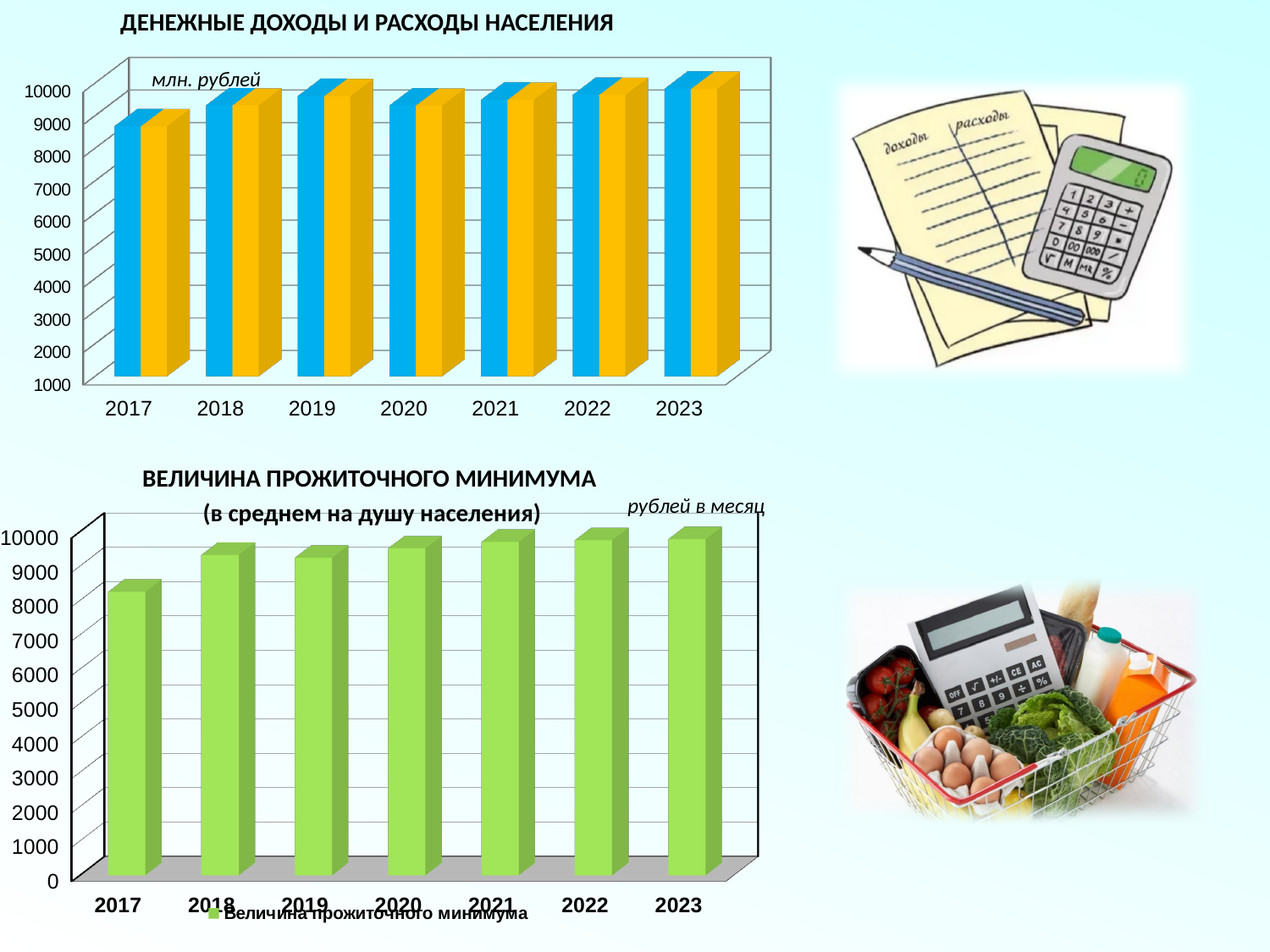
In the bottom chart 'ВЕЛИЧИНА ПРОЖИТОЧНОГО МИНИМУМА', is the value for 2017 greater or less than 9000? less In the top chart 'ДЕНЕЖНЫЕ ДОХОДЫ И РАСХОДЫ НАСЕЛЕНИЯ', is the blue bar for 2019 greater or less than 9000? greater In the bottom chart 'ВЕЛИЧИНА ПРОЖИТОЧНОГО МИНИМУМА', how many series does the legend list? 1 In the bottom chart 'ВЕЛИЧИНА ПРОЖИТОЧНОГО МИНИМУМА', which year has the lowest value? 2017 In the bottom chart 'ВЕЛИЧИНА ПРОЖИТОЧНОГО МИНИМУМА', how many bars are there? 7 In the top chart 'ДЕНЕЖНЫЕ ДОХОДЫ И РАСХОДЫ НАСЕЛЕНИЯ', which year has the lowest bars? 2017 In the top chart 'ДЕНЕЖНЫЕ ДОХОДЫ И РАСХОДЫ НАСЕЛЕНИЯ', how many years are shown on the x axis? 7 What kind of chart is the bottom chart titled 'ВЕЛИЧИНА ПРОЖИТОЧНОГО МИНИМУМА'? Bar chart What kind of chart is the top chart titled 'ДЕНЕЖНЫЕ ДОХОДЫ И РАСХОДЫ НАСЕЛЕНИЯ'? Bar chart In the top chart 'ДЕНЕЖНЫЕ ДОХОДЫ И РАСХОДЫ НАСЕЛЕНИЯ', is the blue bar for 2017 greater or less than 8000? greater In the top chart 'ДЕНЕЖНЫЕ ДОХОДЫ И РАСХОДЫ НАСЕЛЕНИЯ', what unit is written above the chart area? млн. рублей